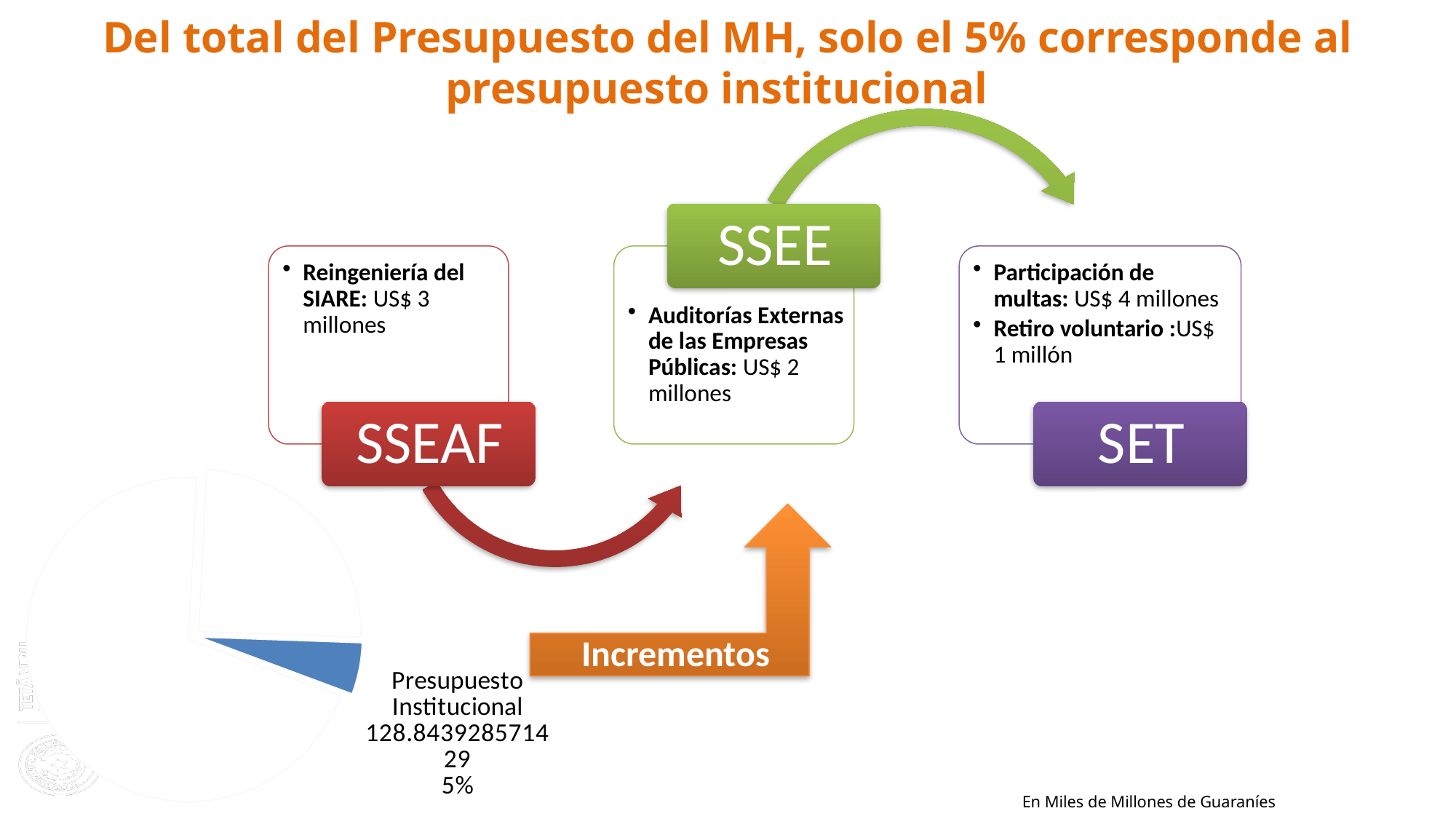
In what units are the values of the pie chart expressed, according to the note at the bottom right of the slide? En Miles de Millones de Guaraníes What colour is the Presupuesto Institucional slice in the pie chart? blue What value is printed on the data label for the Presupuesto Institucional slice of the pie chart? 128.843928571429 What kind of chart is shown in the bottom-left of the slide? pie chart What share of the pie does the Presupuesto Institucional slice represent? 5% Is the share of the Presupuesto Institucional slice greater or less than 50% of the pie? less